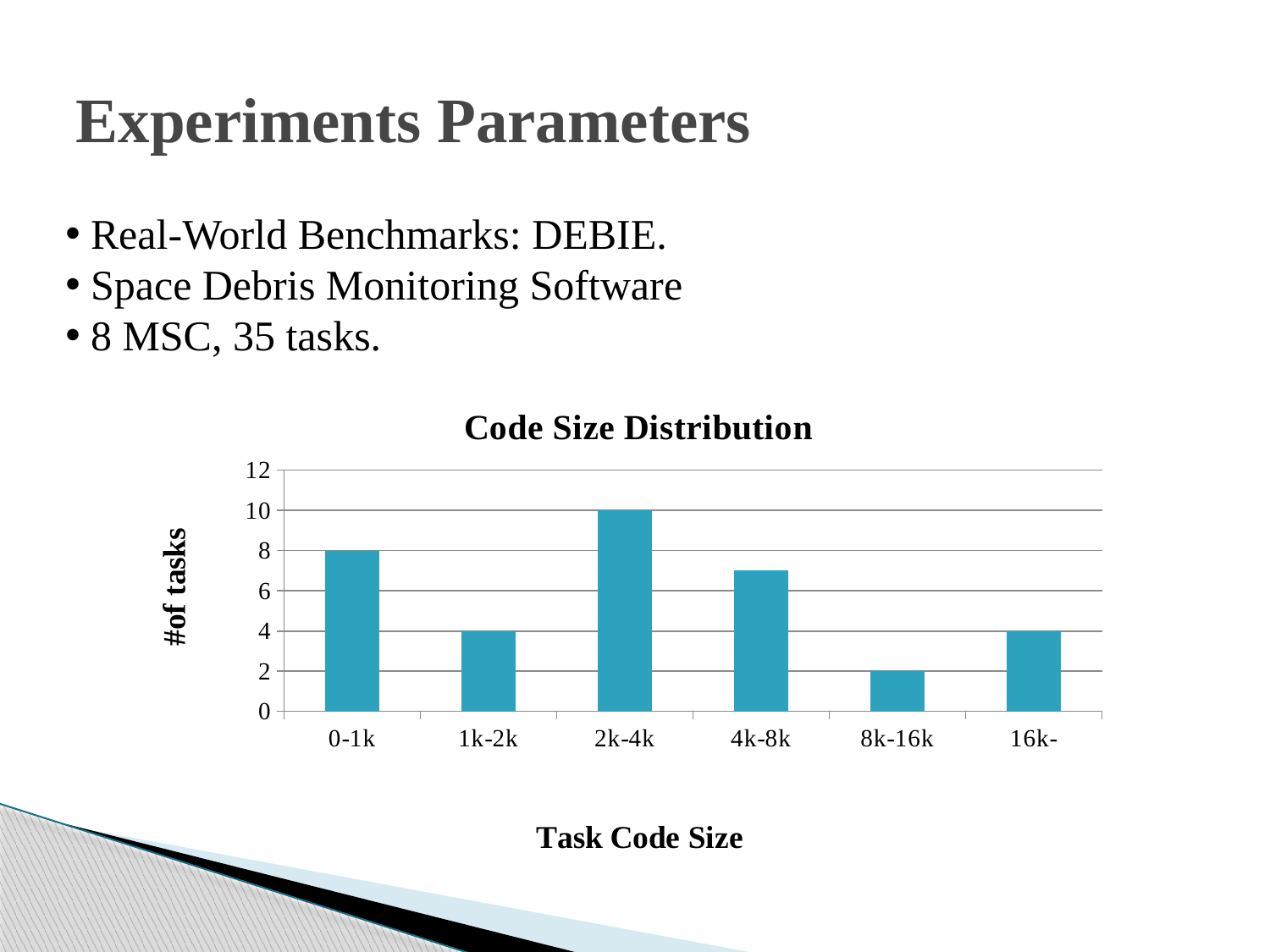
How many tasks are in the 0-1k code size category? 8 Is the number of tasks for 4k-8k greater or less than 6? greater How many tasks are in the 2k-4k code size category? 10 What type of chart is shown on the slide? bar chart What is the difference in number of tasks between the 2k-4k and 0-1k categories? 2 What is the title of the chart? Code Size Distribution Which task code size category has the lowest number of tasks? 8k-16k Which task code size category has the highest number of tasks? 2k-4k What is the label of the y axis? #of tasks How many task code size categories are shown on the x axis? 6 How many tasks are in the 8k-16k code size category? 2 Which has more tasks, the 0-1k category or the 1k-2k category? 0-1k